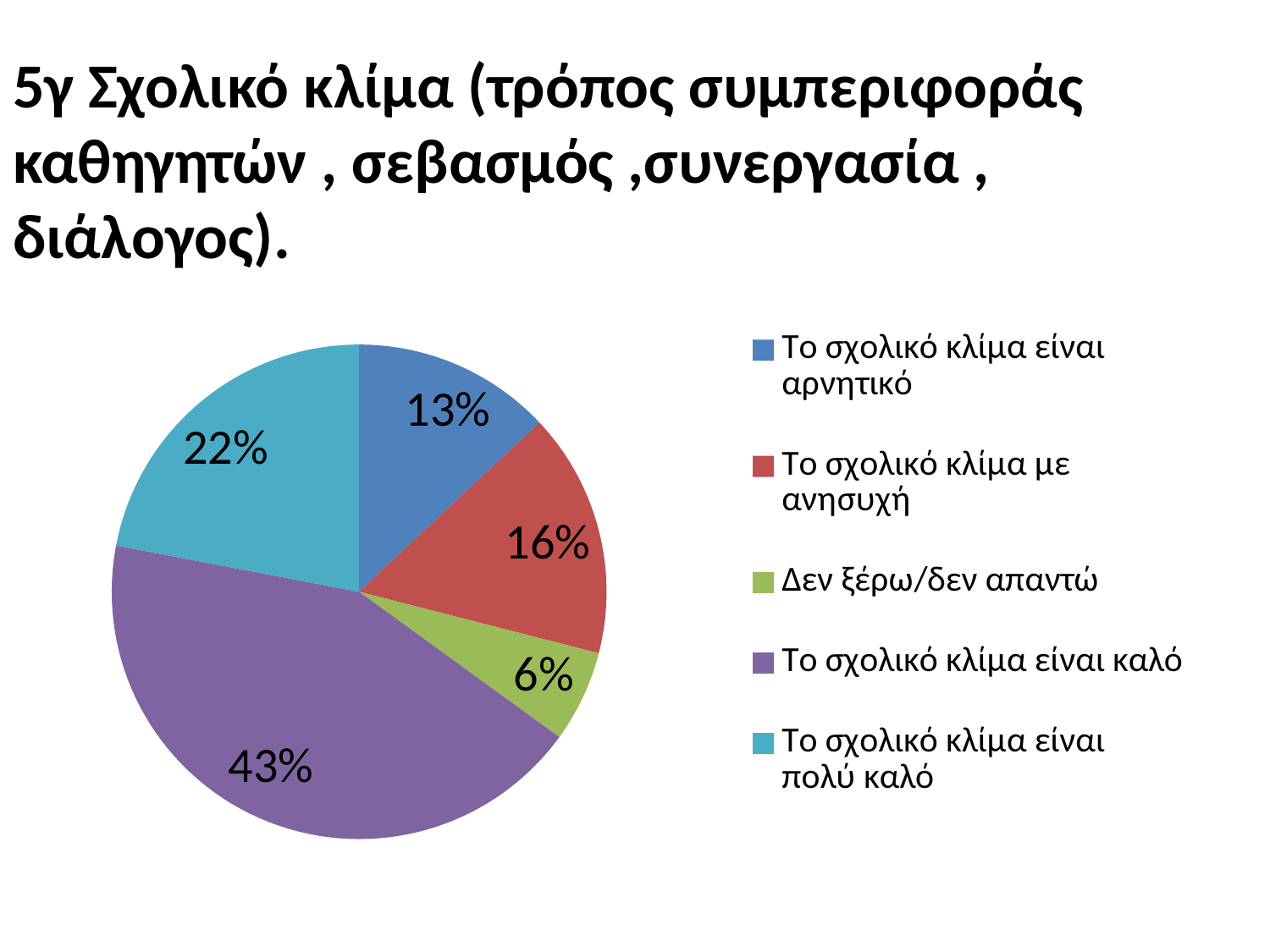
Which category has the smallest slice of the pie? Δεν ξέρω/δεν απαντώ What share of the pie does 'Το σχολικό κλίμα είναι καλό' represent? 43% What is the difference between the values for 'Το σχολικό κλίμα είναι καλό' and 'Το σχολικό κλίμα είναι πολύ καλό'? 21% What kind of chart is shown on the slide? Pie chart How many categories does the pie chart show? 5 What colour is the slice for 'Το σχολικό κλίμα είναι πολύ καλό'? Teal (light blue) What is the value shown for 'Το σχολικό κλίμα με ανησυχή'? 16% What is the value shown for 'Δεν ξέρω/δεν απαντώ'? 6% Which category has the largest slice of the pie? Το σχολικό κλίμα είναι καλό Which is larger: the value for 'Το σχολικό κλίμα με ανησυχή' or the value for 'Το σχολικό κλίμα είναι αρνητικό'? Το σχολικό κλίμα με ανησυχή What is the value shown for 'Το σχολικό κλίμα είναι αρνητικό'? 13% What is the value shown for 'Το σχολικό κλίμα είναι πολύ καλό'? 22%